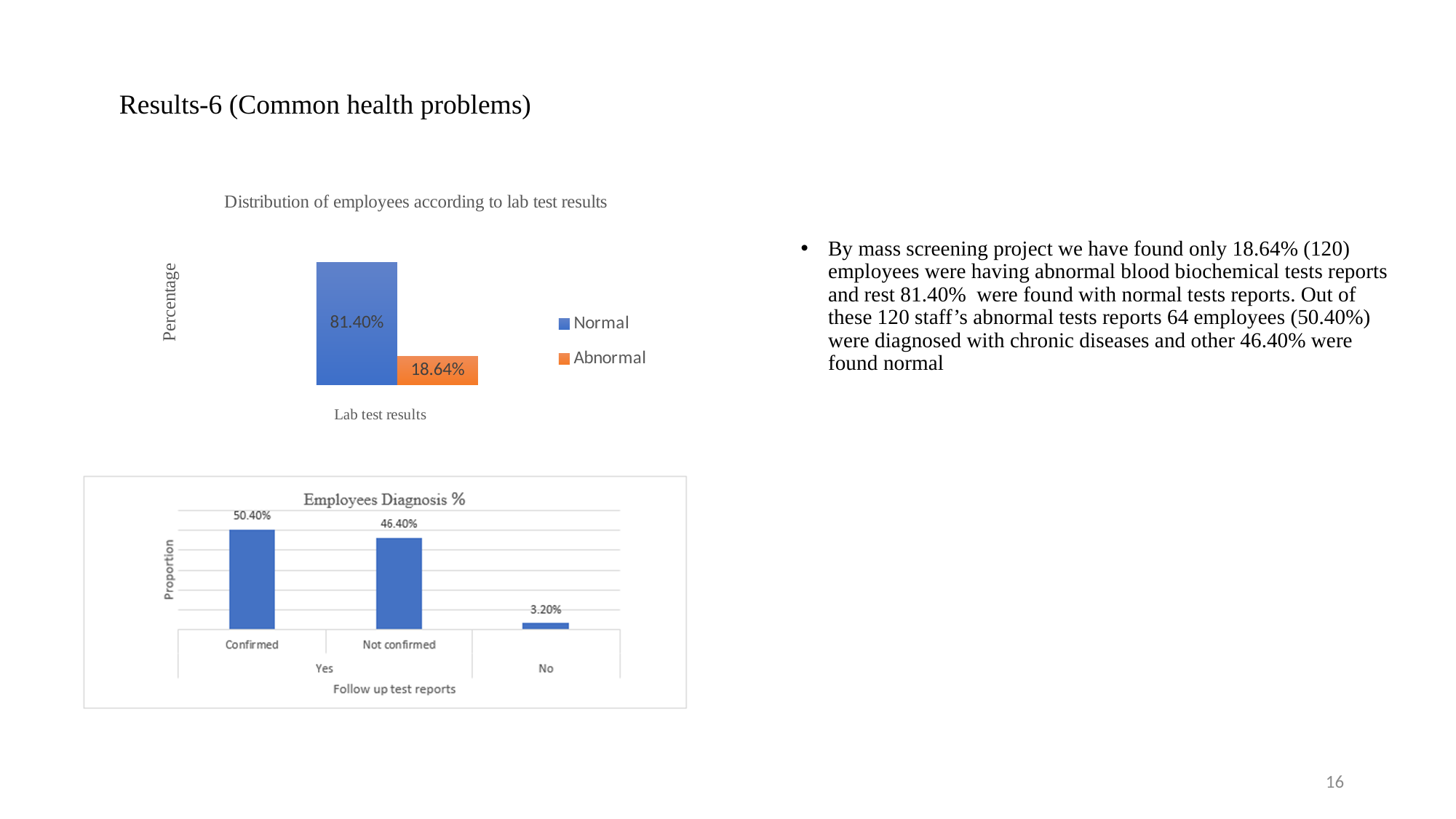
In the 'Distribution of employees according to lab test results' chart, what is the value for Abnormal? 18.64% In the 'Employees Diagnosis %' chart, what is the value for Confirmed? 50.40% In the 'Employees Diagnosis %' chart, which category has the lowest value? No In the 'Distribution of employees according to lab test results' chart, what is the value for Normal? 81.40% In the 'Distribution of employees according to lab test results' chart, what is the difference between the Normal and Abnormal values? 62.76% In the 'Distribution of employees according to lab test results' chart, how many series does the legend list? 2 In the 'Distribution of employees according to lab test results' chart, which series is larger, Normal or Abnormal? Normal In the 'Employees Diagnosis %' chart, what is the value for No? 3.20% In the 'Employees Diagnosis %' chart, what is the difference between the Confirmed and Not confirmed values? 4.00% In the 'Distribution of employees according to lab test results' chart, what colour is the Abnormal bar? Orange In the 'Employees Diagnosis %' chart, what is the value for Not confirmed? 46.40% What kind of chart is the 'Employees Diagnosis %' chart? Bar chart